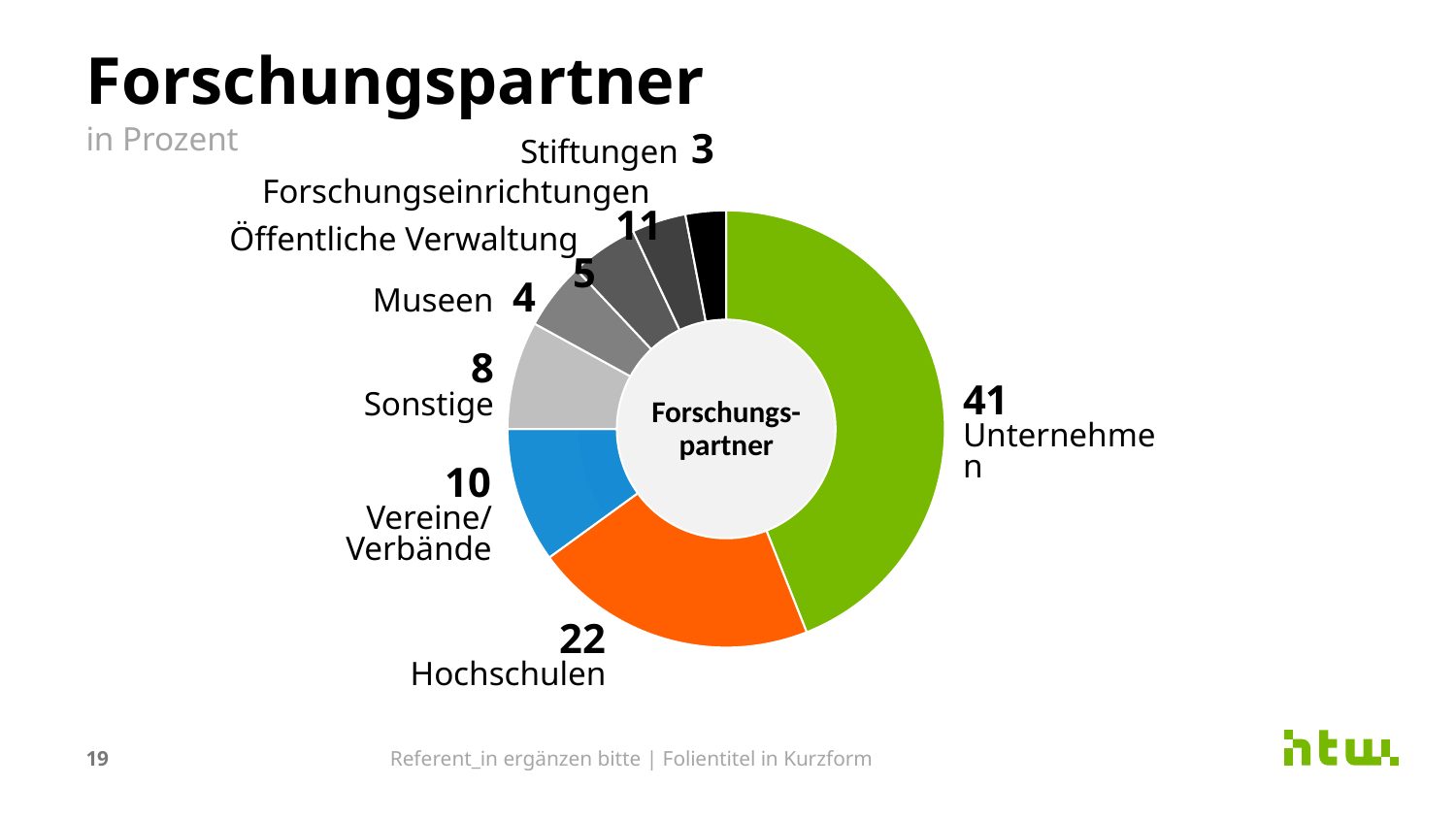
How many categories are shown in the chart? 8 What kind of chart is shown on the slide? Donut (pie) chart Which is larger, the value for Vereine/Verbände or the value for Sonstige? Vereine/Verbände What is the difference between the values for Öffentliche Verwaltung and Museen? 1 What is the value for Hochschulen? 22 What text is written in the centre of the donut chart? Forschungs-partner Which category has the smallest share of the chart? Stiftungen What is the value for Forschungseinrichtungen? 11 What is the value for Stiftungen? 3 What is the difference between the values for Unternehmen and Hochschulen? 19 Which category has the largest share of the chart? Unternehmen What is the value for Unternehmen? 41